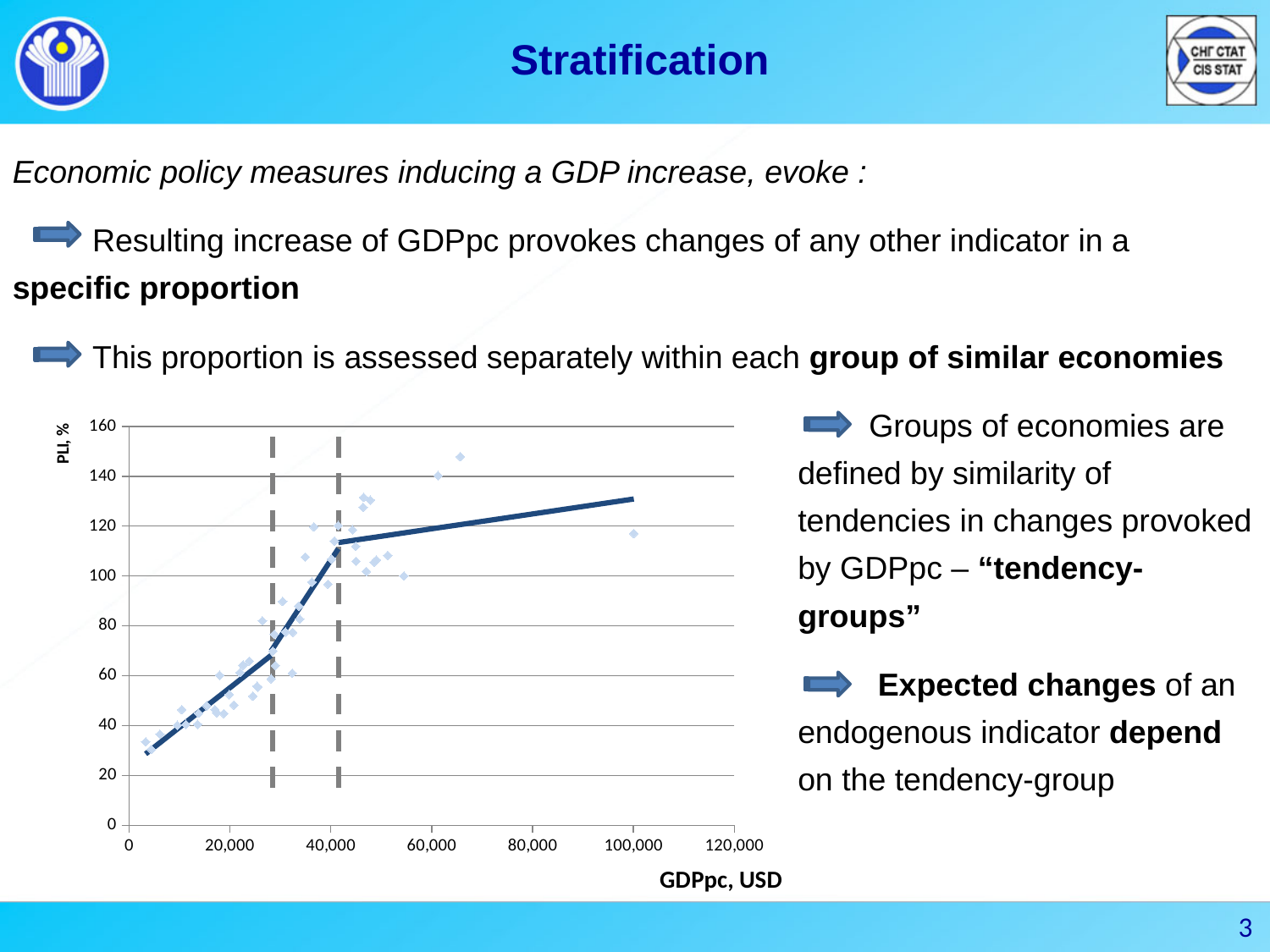
What is the highest value shown on the y axis of the chart? 160 Is the value of the fitted line at GDPpc of 20,000 greater or less than 80? less Does the fitted line in the chart rise or fall as GDPpc increases? rises What is the label of the y axis of the chart? PLI, % What is the label of the x axis of the chart? GDPpc, USD What is the highest value shown on the x axis of the chart? 120,000 Is the value of the fitted line at GDPpc of 60,000 greater or less than 100? greater Is the highest plotted point in the chart greater or less than 140 on the y axis? greater What kind of chart is shown on the slide? scatter chart How many dashed vertical lines divide the chart into groups? 2